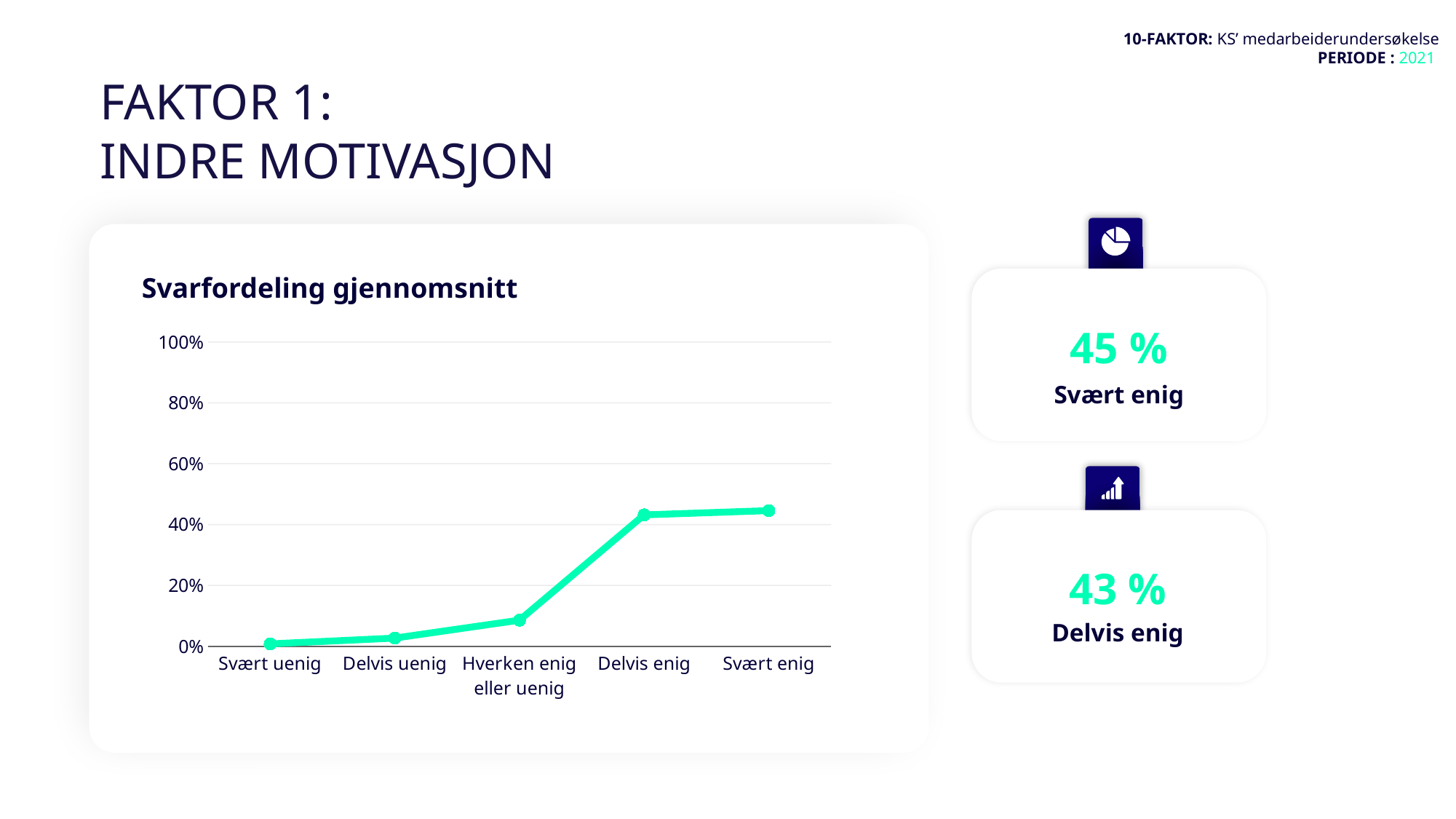
Which is larger in the "Svarfordeling gjennomsnitt" chart: the value for "Delvis uenig" or the value for "Delvis enig"? Delvis enig Do the values in the "Svarfordeling gjennomsnitt" chart rise or fall from "Svært uenig" to "Svært enig"? rise What kind of chart is shown under the title "Svarfordeling gjennomsnitt"? line chart What is the title of the chart on the slide? Svarfordeling gjennomsnitt Is the value for "Delvis enig" greater or less than 40% in the "Svarfordeling gjennomsnitt" chart? greater What is the value for "Delvis enig" in the "Svarfordeling gjennomsnitt" chart? 43 % Which category has the lowest value in the "Svarfordeling gjennomsnitt" chart? Svært uenig What is the value for "Svært enig" in the "Svarfordeling gjennomsnitt" chart? 45 % Is the value for "Hverken enig eller uenig" greater or less than 20% in the "Svarfordeling gjennomsnitt" chart? less How many categories are plotted along the x axis of the "Svarfordeling gjennomsnitt" chart? 5 Which category has the highest value in the "Svarfordeling gjennomsnitt" chart? Svært enig